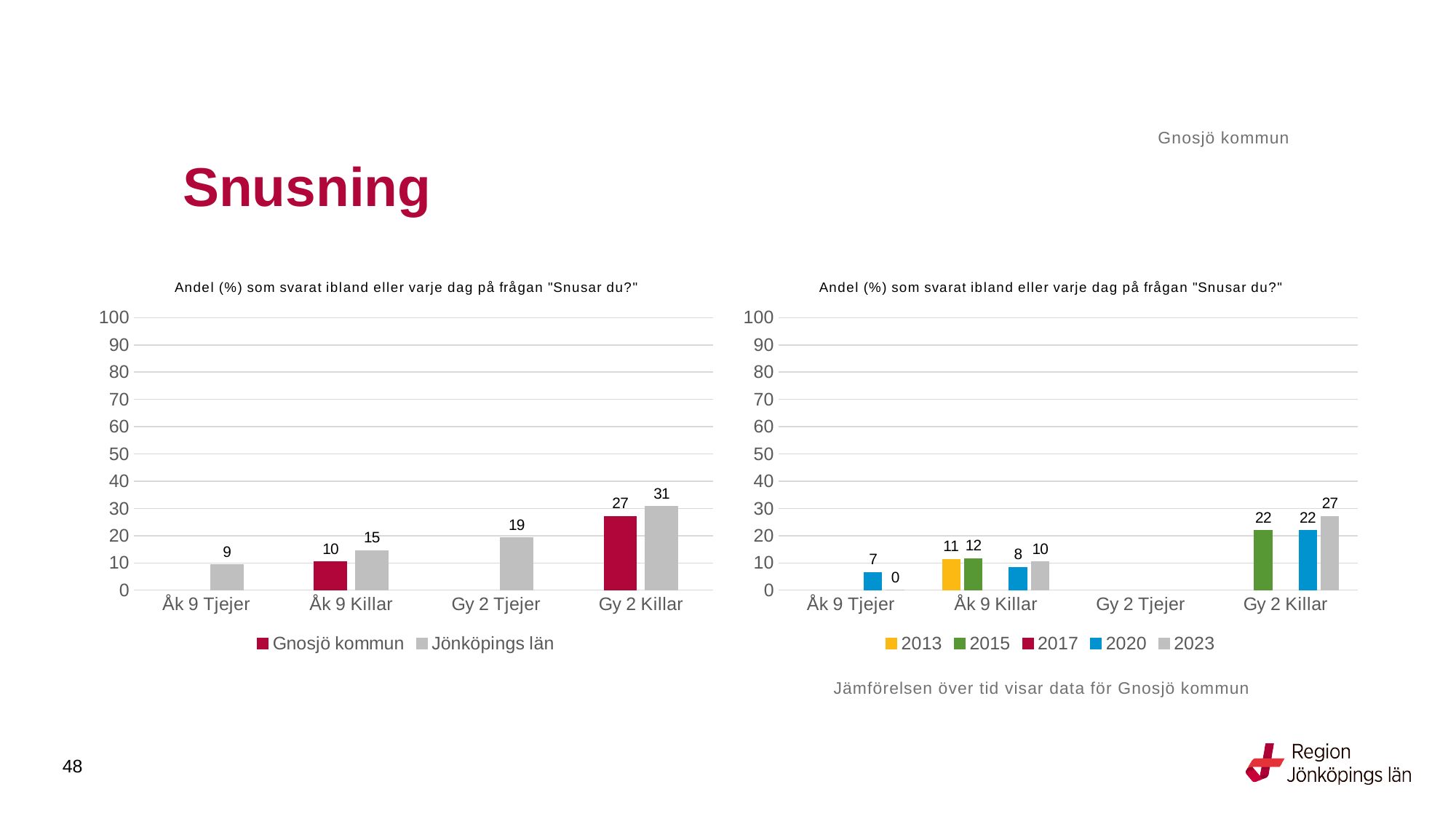
In the right chart, what is the value for 2013 for Åk 9 Killar? 11 What kind of chart is the right chart? Bar chart In the left chart, what is the value for Jönköpings län for Gy 2 Killar? 31 In the right chart, which is larger for Åk 9 Killar: 2015 or 2020? 2015 In the left chart, what is the value for Gnosjö kommun for Åk 9 Killar? 10 In the left chart, what is the difference between Jönköpings län and Gnosjö kommun for Gy 2 Killar? 4 In the left chart, which category has the lowest value for Jönköpings län? Åk 9 Tjejer In the left chart, which category has the highest value for Jönköpings län? Gy 2 Killar In the right chart, how many series does the legend list? 5 In the right chart, what is the value for 2023 for Gy 2 Killar? 27 In the left chart, how many series does the legend list? 2 In the right chart, what is the difference between 2023 and 2020 for Gy 2 Killar? 5